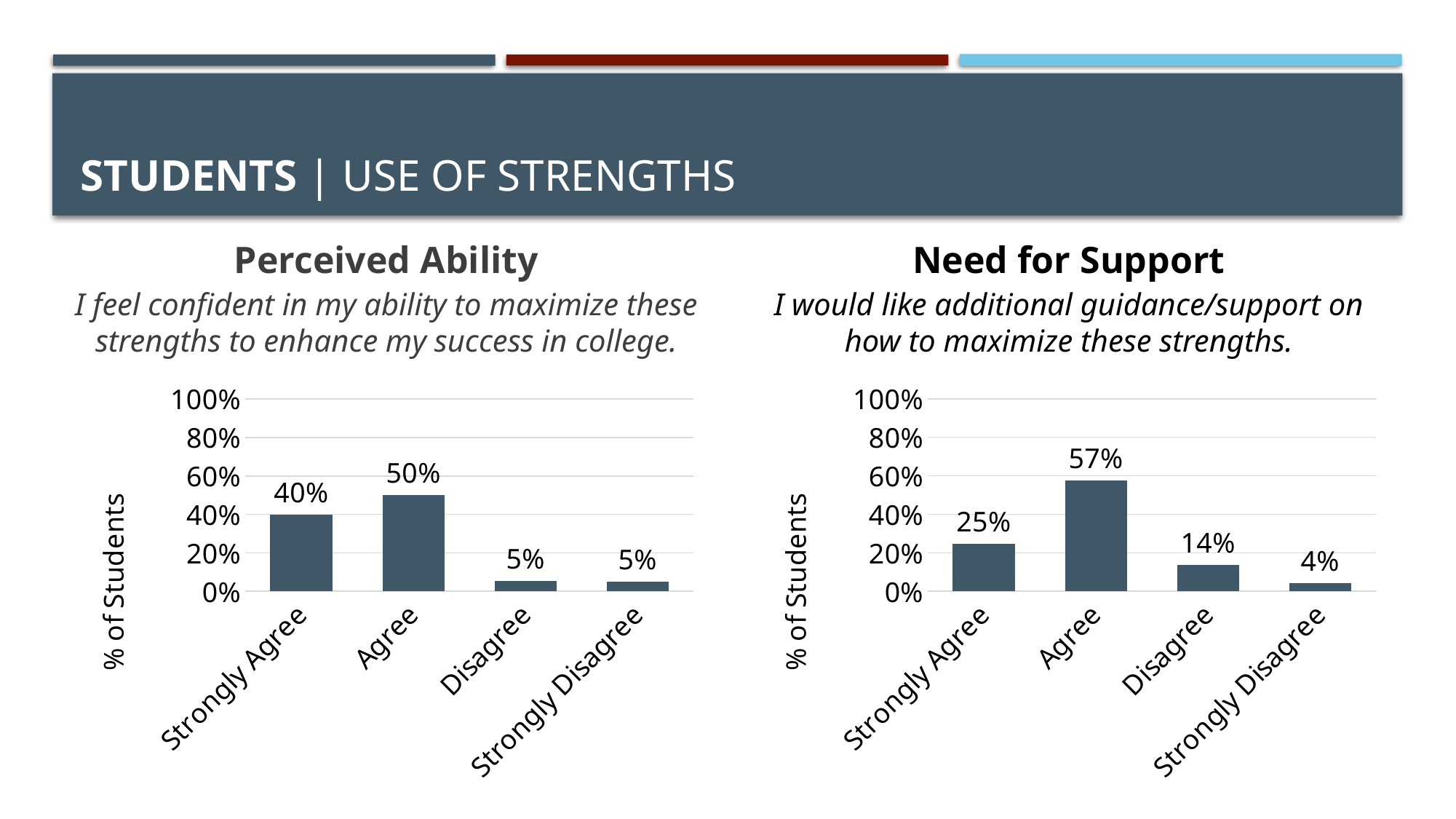
In the Perceived Ability chart, what percentage of students selected Agree? 50% In the Perceived Ability chart, which category has the highest value? Agree What type of chart is the Perceived Ability chart? Bar chart In the Need for Support chart, what percentage of students selected Strongly Agree? 25% In the Need for Support chart, what is the value for Disagree? 14% In the Need for Support chart, which category has the lowest value? Strongly Disagree In the Perceived Ability chart, is the value for Agree greater or less than 40%? greater In the Perceived Ability chart, what is the difference between the Agree and Strongly Agree values? 10% How many categories are shown on the x axis of the Need for Support chart? 4 What is the y-axis label of the Need for Support chart? % of Students In the Need for Support chart, what is the difference between the Agree and Disagree values? 43% In the Need for Support chart, which is larger, Strongly Agree or Disagree? Strongly Agree